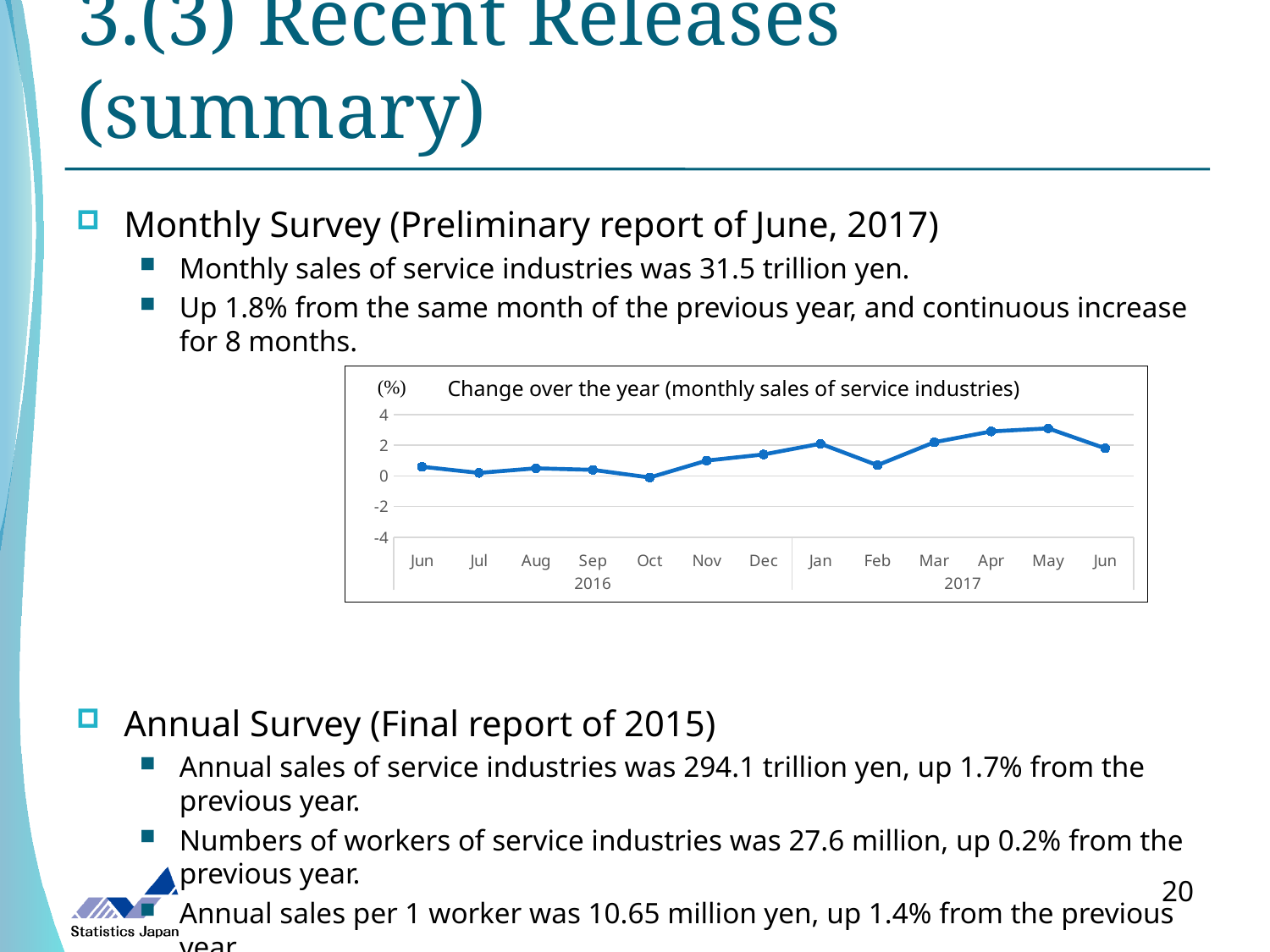
Is the value for Jul 2016 greater or less than 2? less How many monthly data points are plotted on the chart? 13 What is the title of the chart? Change over the year (monthly sales of service industries) Which is larger, the value for Jan 2017 or the value for Feb 2017? Jan 2017 What kind of chart is shown on the slide? line chart Which month has the highest value on the chart? May 2017 Which month has the lowest value on the chart? Oct 2016 What unit is shown on the vertical axis of the chart? (%) Do the values rise or fall from Feb 2017 to May 2017? rise Is the value for Apr 2017 greater or less than 2? greater Which is larger, the value for Dec 2016 or the value for Jul 2016? Dec 2016